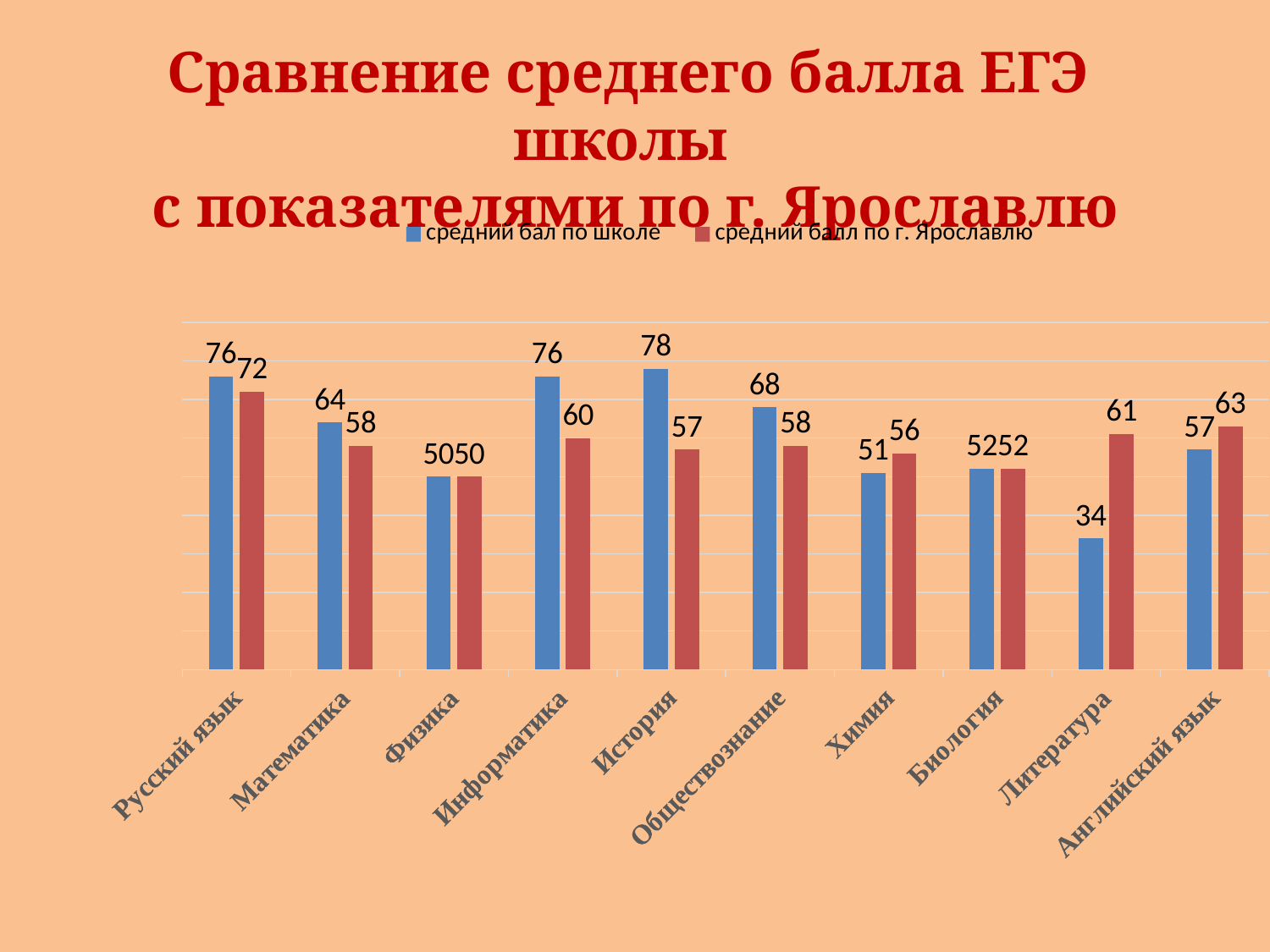
What is the school average score (средний бал по школе) for История? 78 For Химия, which is larger: the school average or the Yaroslavl city average? the Yaroslavl city average Which subject has the highest school average score? История What is the Yaroslavl city average score (средний балл по г. Ярославлю) for Литература? 61 Which subject has the lowest school average score? Литература For Математика, which is larger: the school average or the Yaroslavl city average? the school average How many subjects are shown on the x axis of the chart? 10 What is the difference between the school average and the Yaroslavl average for История? 21 What kind of chart is shown on the slide? bar chart How many series does the legend list? 2 What is the school average score for Информатика? 76 What is the difference between the school average and the Yaroslavl average for Литература? 27